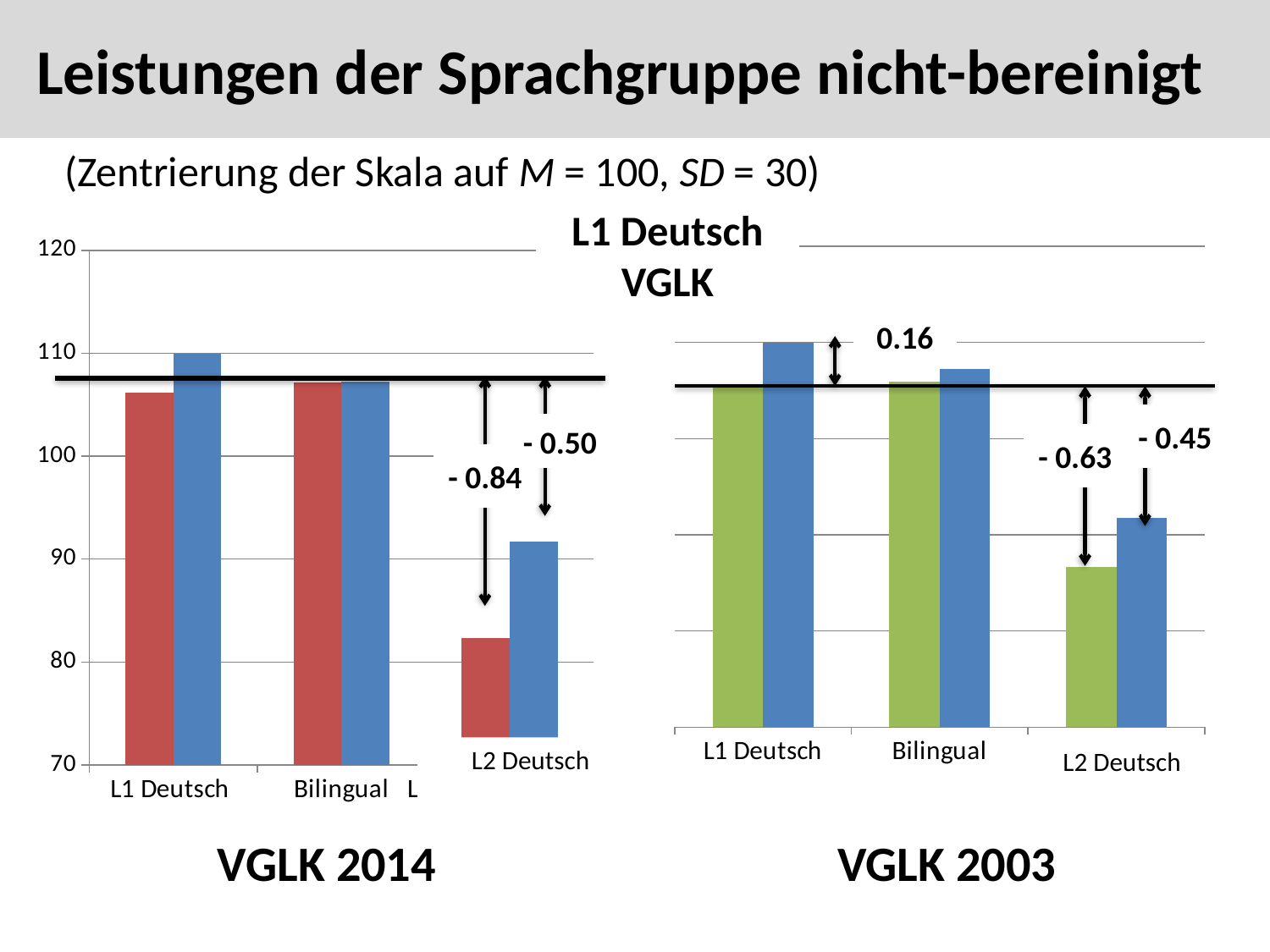
In the VGLK 2014 chart, is the value of the red bar for L2 Deutsch greater or less than 90? less In the VGLK 2014 chart, for L2 Deutsch, which bar is taller, the red one or the blue one? The blue one In the VGLK 2014 chart, is the value of the blue bar for L2 Deutsch greater or less than 100? less In the VGLK 2003 chart, what effect size is annotated above the L1 Deutsch bars? 0.16 In the VGLK 2014 chart, which category has the lowest bars? L2 Deutsch In the VGLK 2014 chart, what effect size is annotated next to the red bar for L2 Deutsch? - 0.84 In the VGLK 2003 chart, how many categories are shown on the x axis? 3 What type of chart is used on this slide for VGLK 2014 and VGLK 2003? Bar chart In the VGLK 2003 chart, which category contains the tallest bar? L1 Deutsch In the VGLK 2014 chart, how many categories are shown on the x axis? 3 In the VGLK 2014 chart, is the value of the blue bar for L1 Deutsch greater or less than 100? greater In the VGLK 2003 chart, what effect size is annotated next to the blue bar for L2 Deutsch? - 0.45